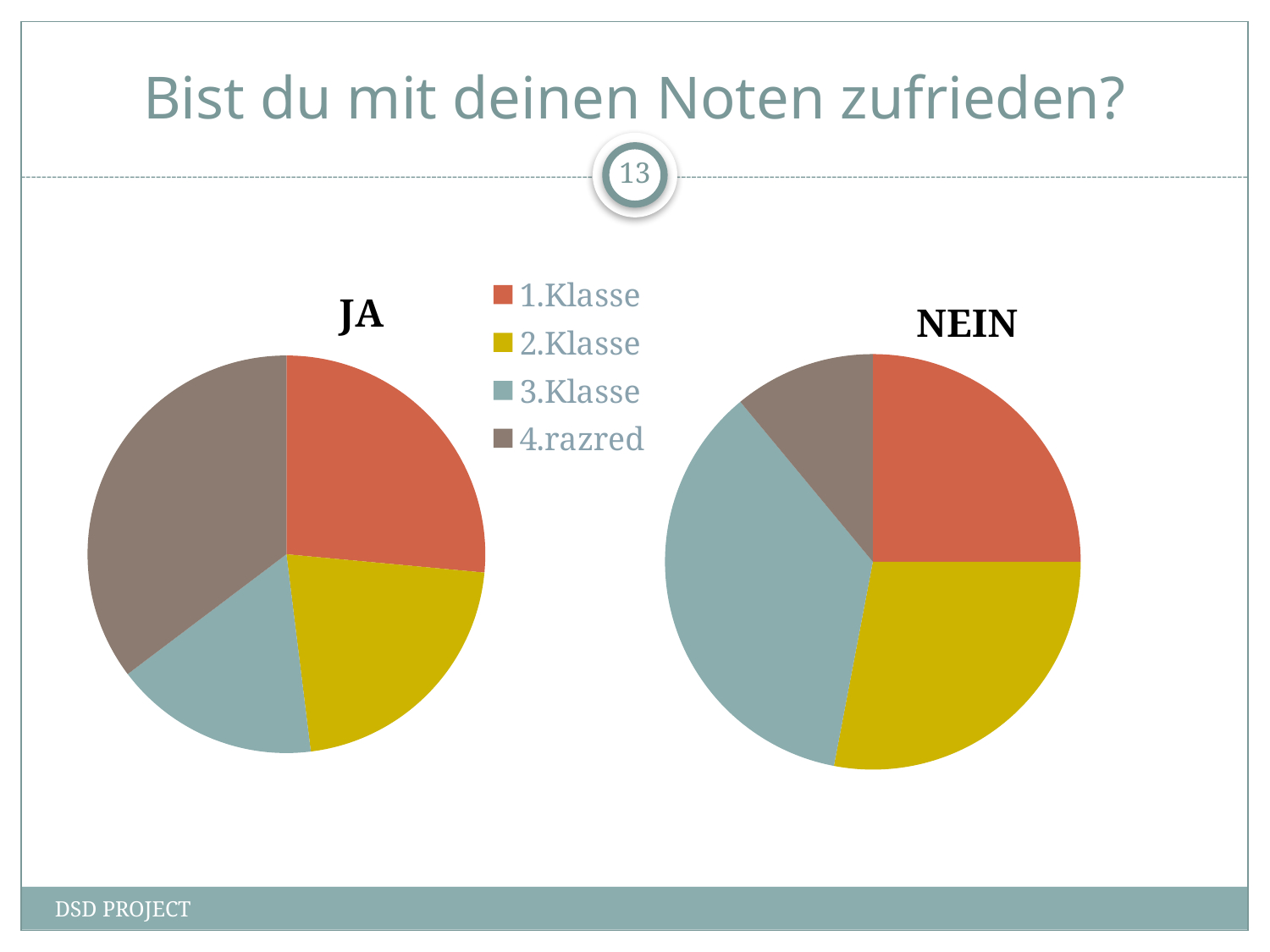
In the "NEIN" chart, which slice is larger: 3.Klasse or 4.razred? 3.Klasse In the "NEIN" chart, which category has the largest slice? 3.Klasse In the "NEIN" chart, which category has the smallest slice? 4.razred In the "JA" chart, which slice is larger: 4.razred or 3.Klasse? 4.razred In the "JA" chart, which category has the smallest slice? 3.Klasse How many slices does the "JA" pie chart have? 4 What kind of chart is the "JA" chart? pie chart How many entries does the legend list? 4 Which legend entry is shown in yellow? 2.Klasse What is the title of the slide containing the two pie charts? Bist du mit deinen Noten zufrieden? What kind of chart is the "NEIN" chart? pie chart In the "JA" chart, which category has the largest slice? 4.razred